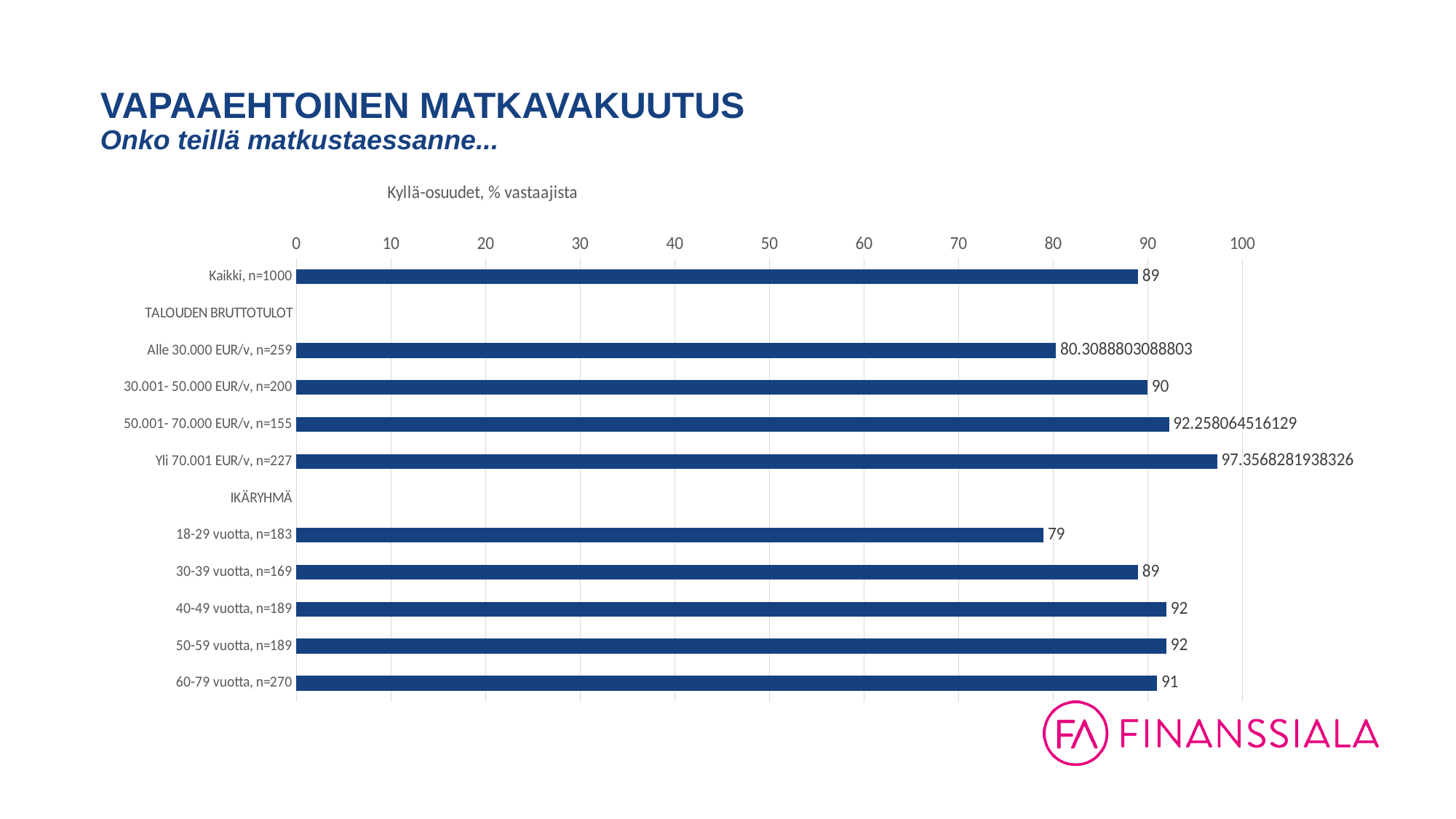
What is the chart's title? Kyllä-osuudet, % vastaajista What is the value for 18-29 vuotta, n=183? 79 What is the value for 60-79 vuotta, n=270? 91 What kind of chart is shown on the slide? bar chart What is the value for Yli 70.001 EUR/v, n=227? 97.3568281938326 What is the value for Kaikki, n=1000? 89 What is the value for 30.001- 50.000 EUR/v, n=200? 90 Is the value for Alle 30.000 EUR/v, n=259 greater or less than 90? less Which category has the lowest value? 18-29 vuotta, n=183 Which category has the highest value? Yli 70.001 EUR/v, n=227 Which is larger, the value for 30-39 vuotta, n=169 or the value for 60-79 vuotta, n=270? 60-79 vuotta, n=270 What is the difference between the values for 40-49 vuotta, n=189 and 18-29 vuotta, n=183? 13